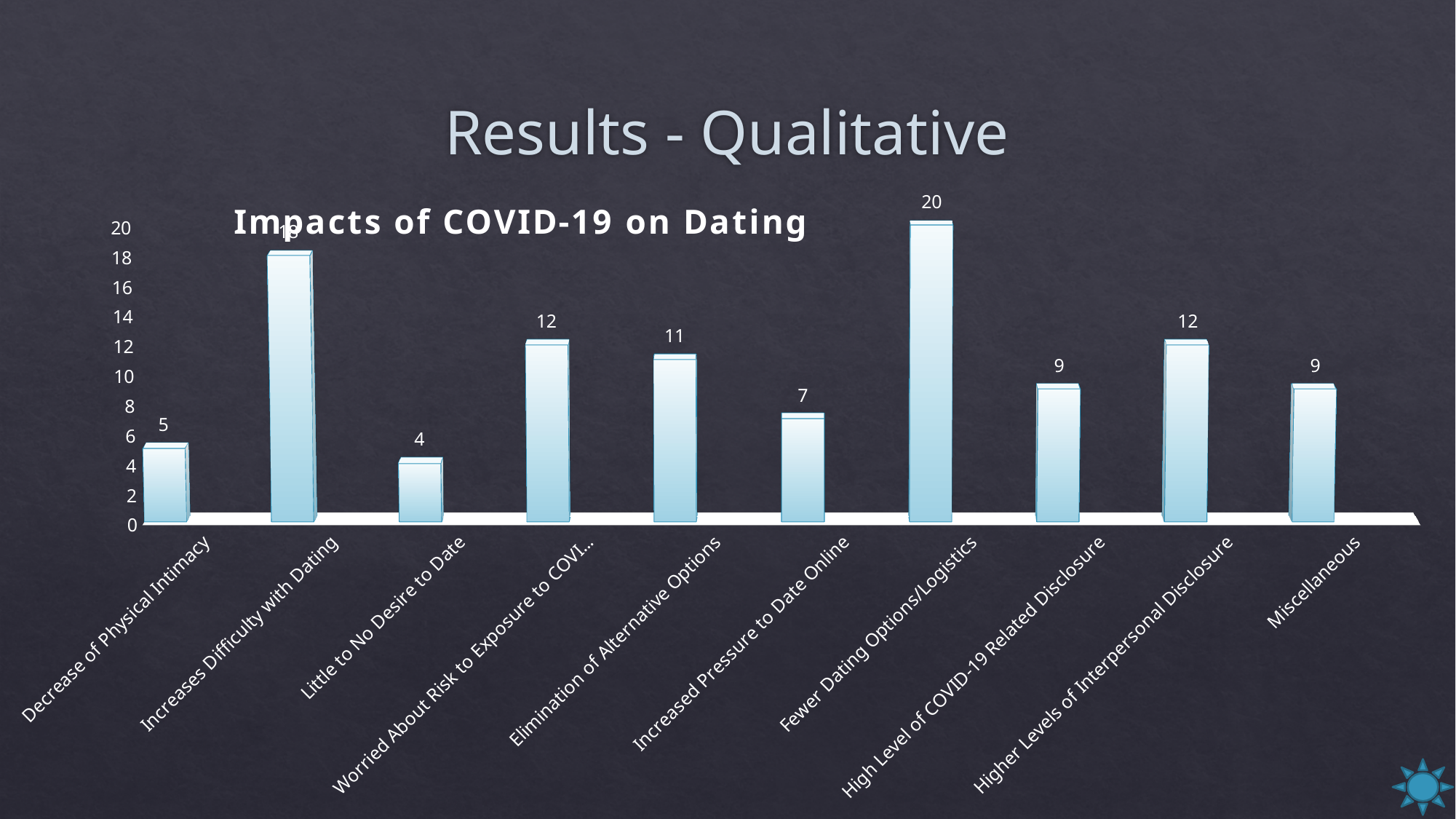
What is the value for Elimination of Alternative Options? 11 Which category has the lowest value? Little to No Desire to Date What is the value for Miscellaneous? 9 What is the difference between the values for Fewer Dating Options/Logistics and Higher Levels of Interpersonal Disclosure? 8 What is the value for Fewer Dating Options/Logistics? 20 Is the value for Increases Difficulty with Dating greater or less than 16? greater What is the value for Increased Pressure to Date Online? 7 What kind of chart is shown on the slide? bar chart How many categories are shown on the x axis? 10 Which is larger, the value for Elimination of Alternative Options or the value for High Level of COVID-19 Related Disclosure? Elimination of Alternative Options Which category has the highest value? Fewer Dating Options/Logistics What is the value for Decrease of Physical Intimacy? 5